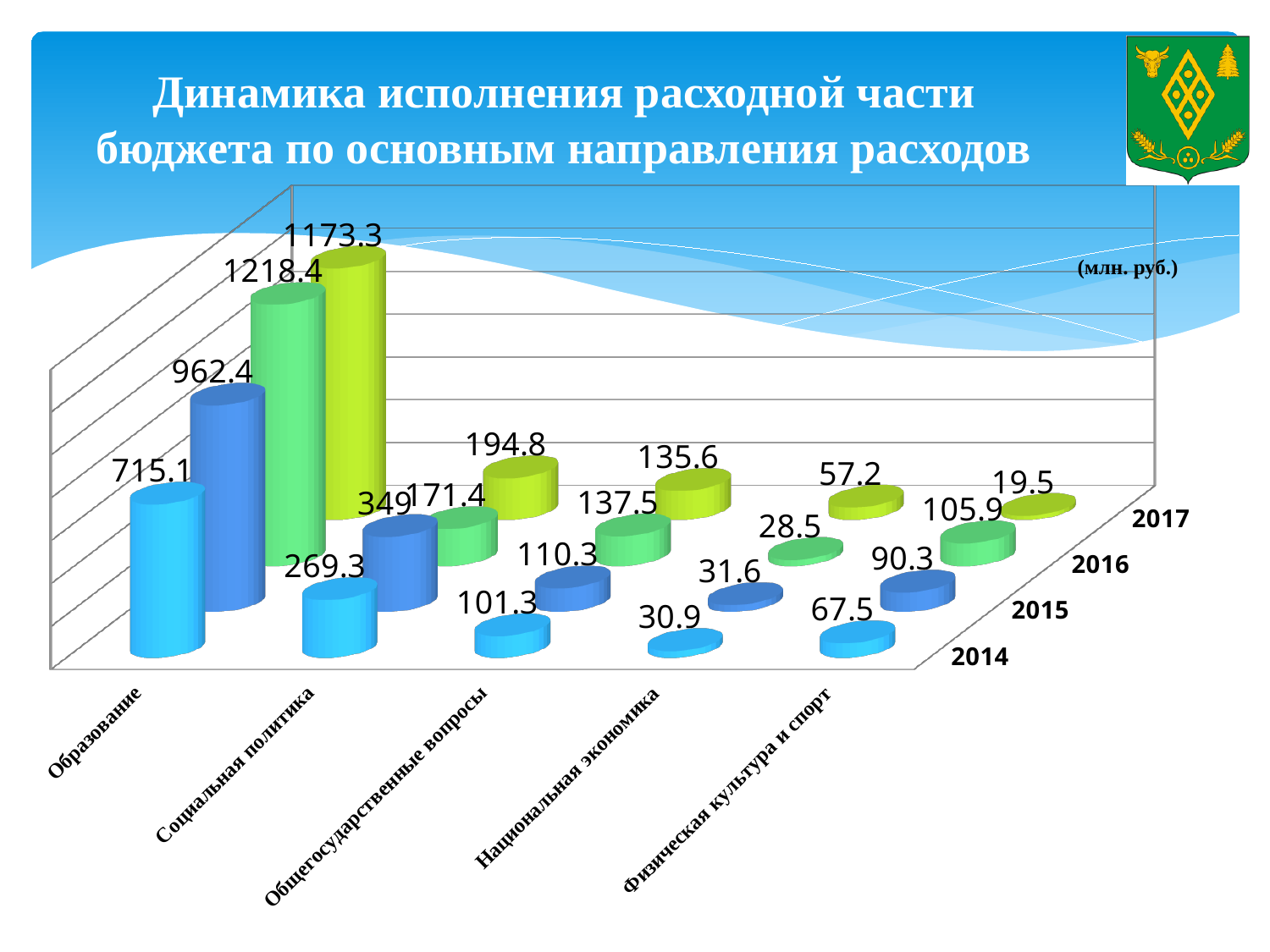
What is the value for Национальная экономика in 2017? 57.2 How many years are plotted in the chart? 4 What is the value for Физическая культура и спорт in 2016? 105.9 What is the difference between the 2016 and 2017 values for Образование? 45.1 What kind of chart is shown on the slide? Bar chart Which category has the highest value in 2016? Образование What unit is indicated for the values in the chart? млн. руб. What is the value for Образование in 2014? 715.1 Which category has the lowest value in 2017? Физическая культура и спорт What is the value for Социальная политика in 2015? 349 Which is larger for Общегосударственные вопросы: the 2014 value or the 2016 value? 2016 How many expenditure categories are shown on the x axis? 5